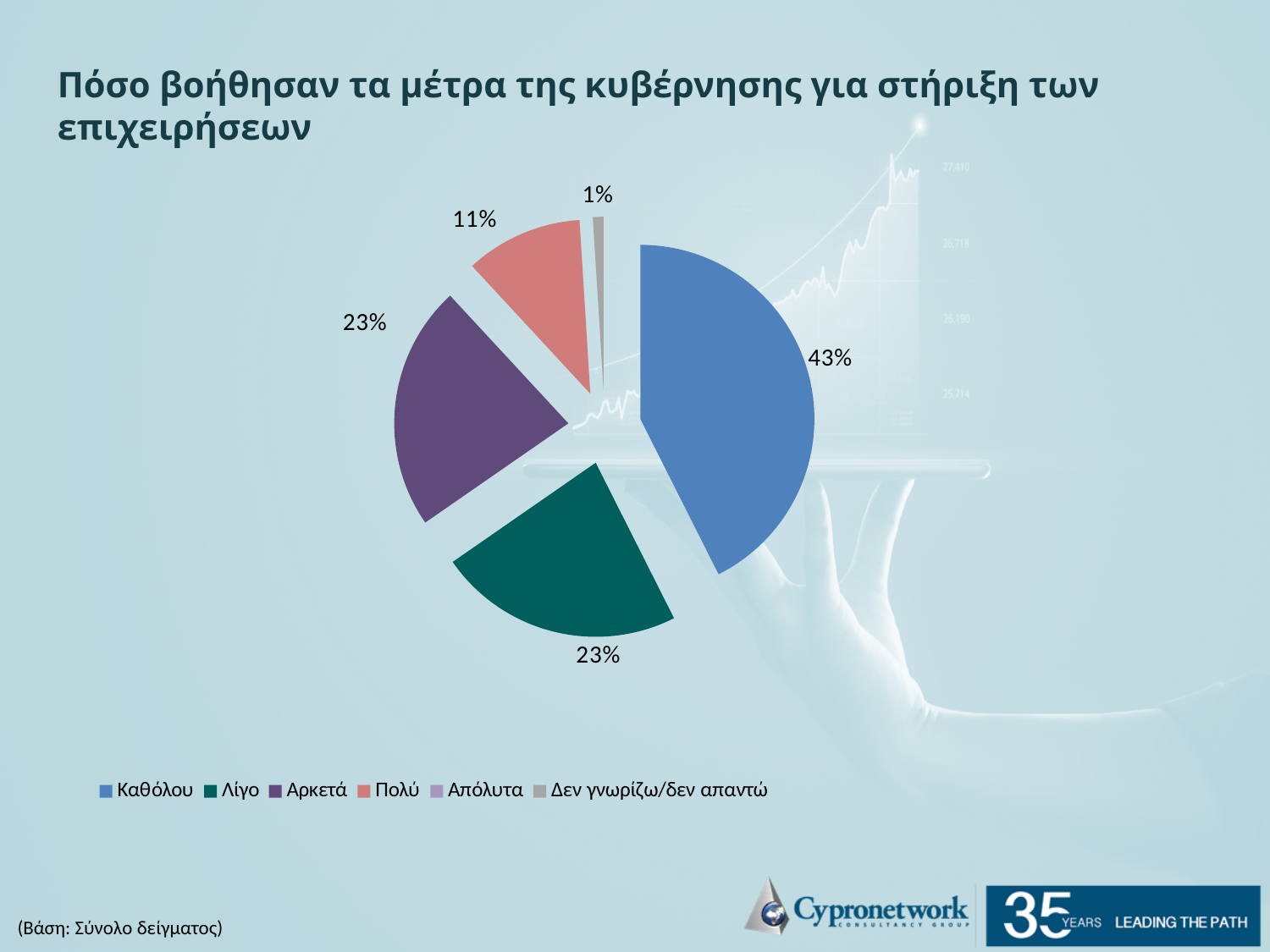
What percentage of respondents answered Πολύ? 11% What colour is the Καθόλου slice in the pie chart? Blue Which is larger, the share for Καθόλου or the share for Λίγο? Καθόλου Which response category has the largest share of the pie? Καθόλου What percentage of respondents answered Λίγο? 23% What percentage of respondents answered Καθόλου? 43% What is the difference in percentage points between the Λίγο and Πολύ slices? 12 percentage points What is the difference in percentage points between the Καθόλου and Πολύ slices? 32 percentage points What kind of chart is shown on the slide? Pie chart What percentage of respondents answered Αρκετά? 23% How many entries does the legend list? 6 What percentage of respondents answered Δεν γνωρίζω/δεν απαντώ? 1%